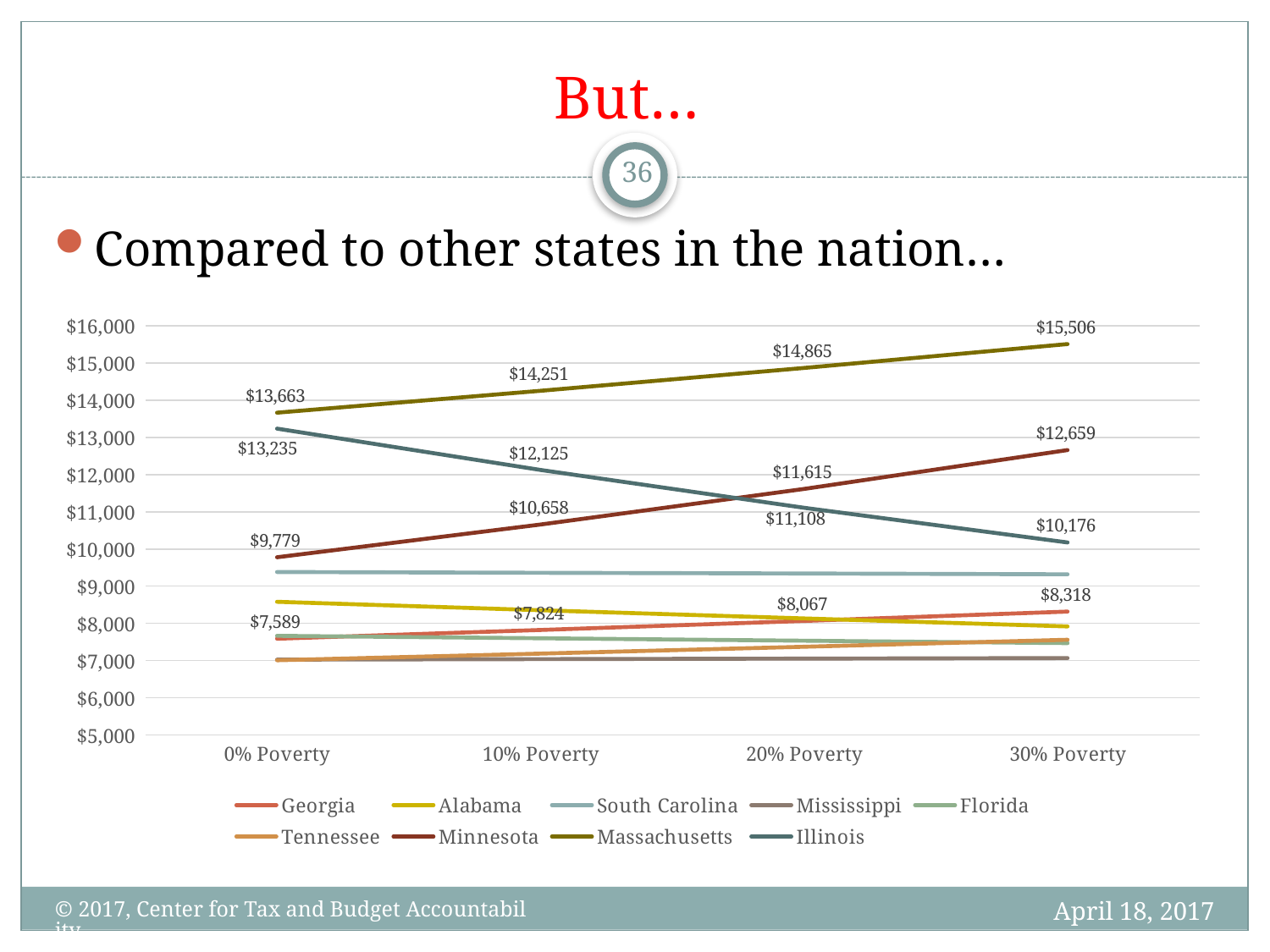
What is the difference between the Massachusetts values at 30% Poverty and 0% Poverty? $1,843 What is the value for Minnesota at 20% Poverty? $11,615 At 10% Poverty, which is larger: the value for Illinois or the value for Minnesota? Illinois How many series does the legend list? 9 Does the Illinois line rise or fall from 0% Poverty to 30% Poverty? fall What is the value for Georgia at 30% Poverty? $8,318 What is the value for Massachusetts at 30% Poverty? $15,506 Which state has the highest value at 30% Poverty? Massachusetts Is the value for South Carolina at 0% Poverty greater or less than $9,000? greater What kind of chart is shown on the slide? line chart What is the value for Illinois at 0% Poverty? $13,235 How many poverty-level categories are shown on the x axis? 4